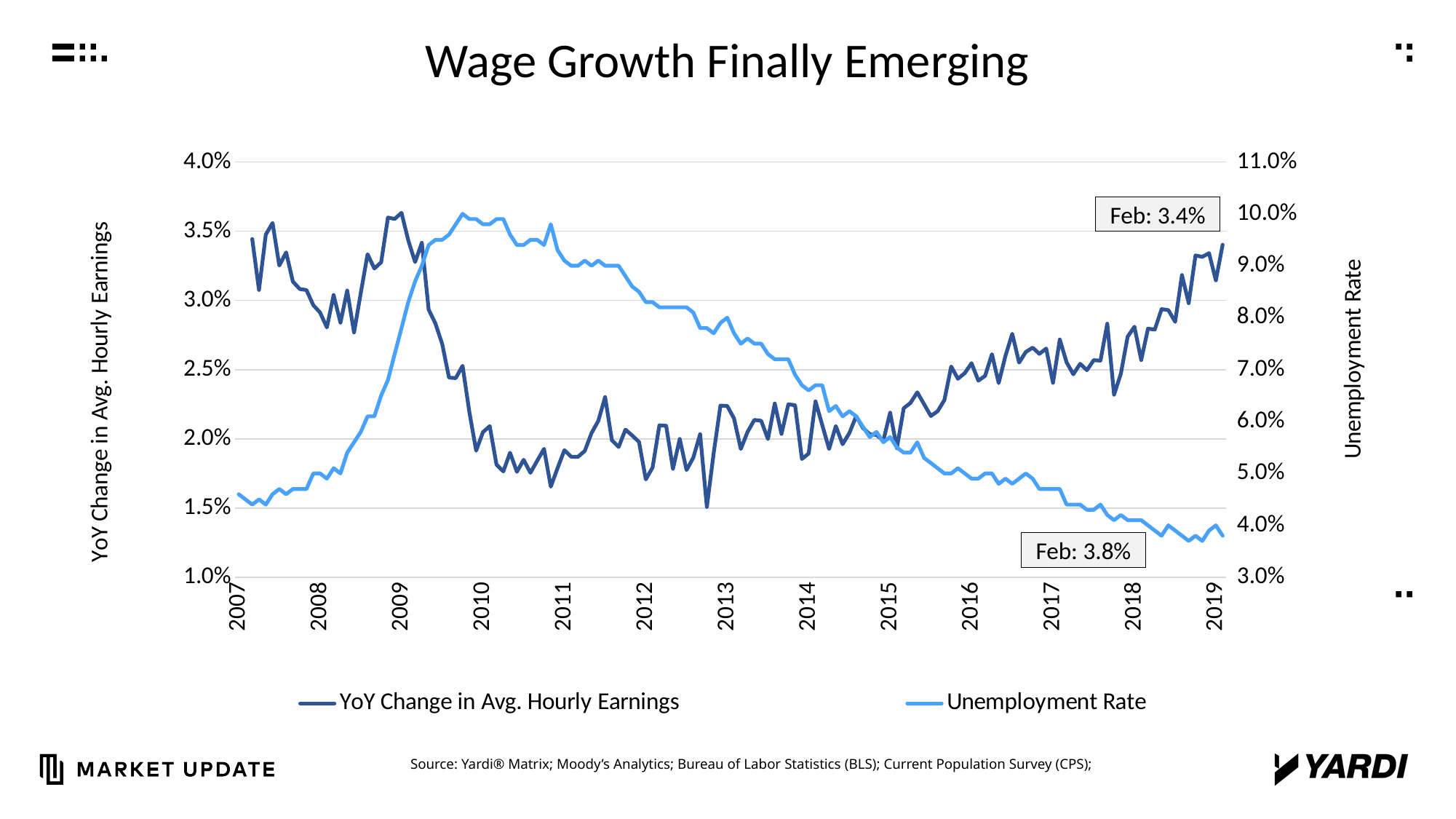
Is the unemployment rate at the start of 2010 greater or less than 9.0%? greater What is the title of the chart? Wage Growth Finally Emerging Does the YoY change in average hourly earnings rise or fall from 2013 to 2019? rise How many series does the legend list? 2 What kind of chart is shown on the slide? line chart Does the unemployment rate rise or fall from 2010 to 2019? fall Is the unemployment rate at the start of 2007 greater or less than 5.0%? less What is the label on the right-hand vertical axis? Unemployment Rate What is the labelled unemployment rate for Feb 2019? 3.8% What is the labelled YoY change in average hourly earnings for Feb 2019? 3.4% Is the YoY change in average hourly earnings in Feb 2019 greater or less than 3.0%? greater